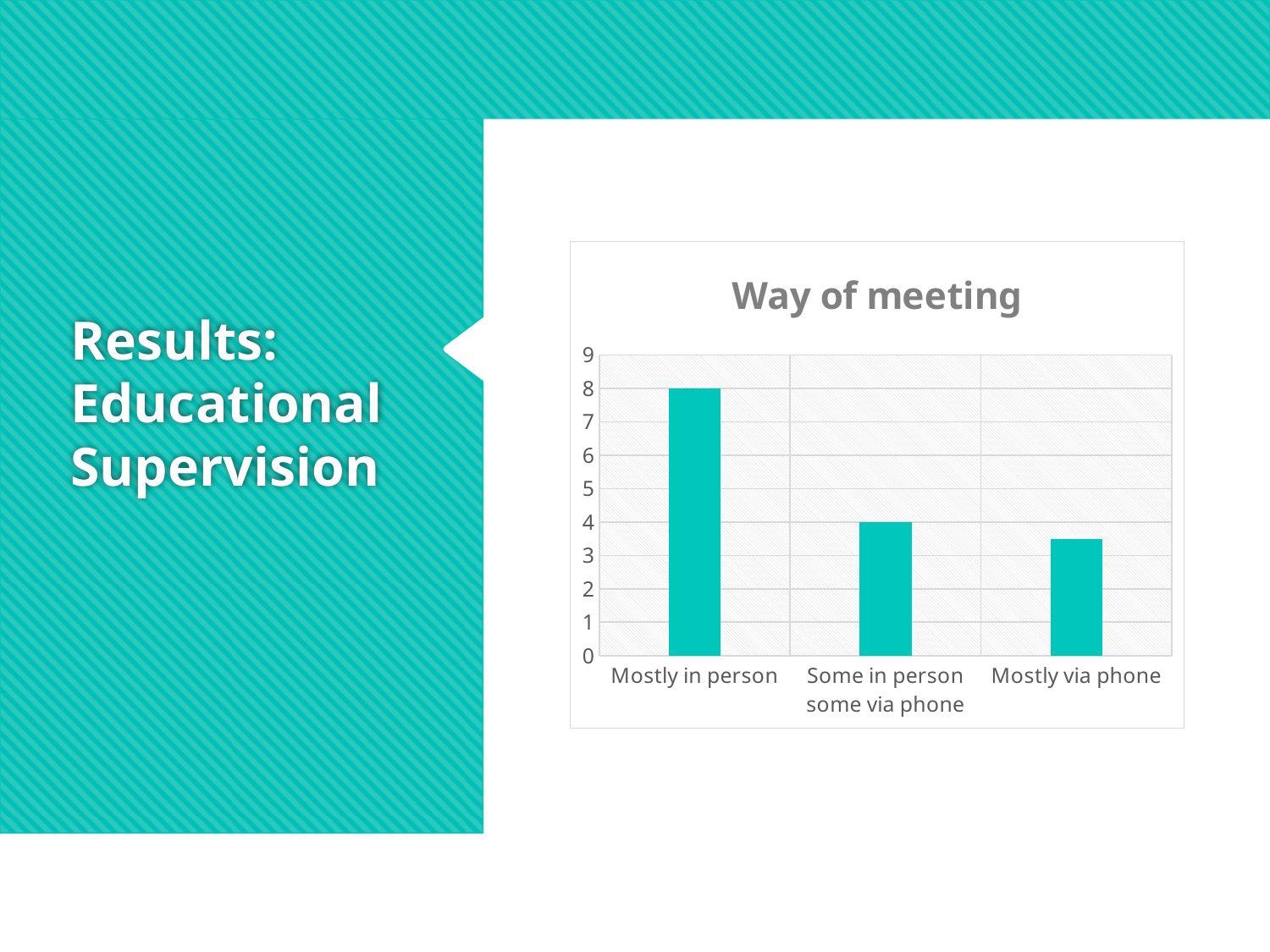
What is the value for Some in person some via phone? 4 Is the value for Mostly via phone greater or less than 3? greater How many categories are shown on the x axis of the chart? 3 Which category has the lowest value? Mostly via phone Which category has the highest value? Mostly in person Which is larger, the value for Some in person some via phone or the value for Mostly via phone? Some in person some via phone Is the value for Mostly via phone greater or less than 4? less What is the value for Mostly in person? 8 What is the difference between the values for Mostly in person and Some in person some via phone? 4 Do the values rise or fall from left to right along the x axis? fall What type of chart is shown on the slide? bar chart What is the title of the chart? Way of meeting